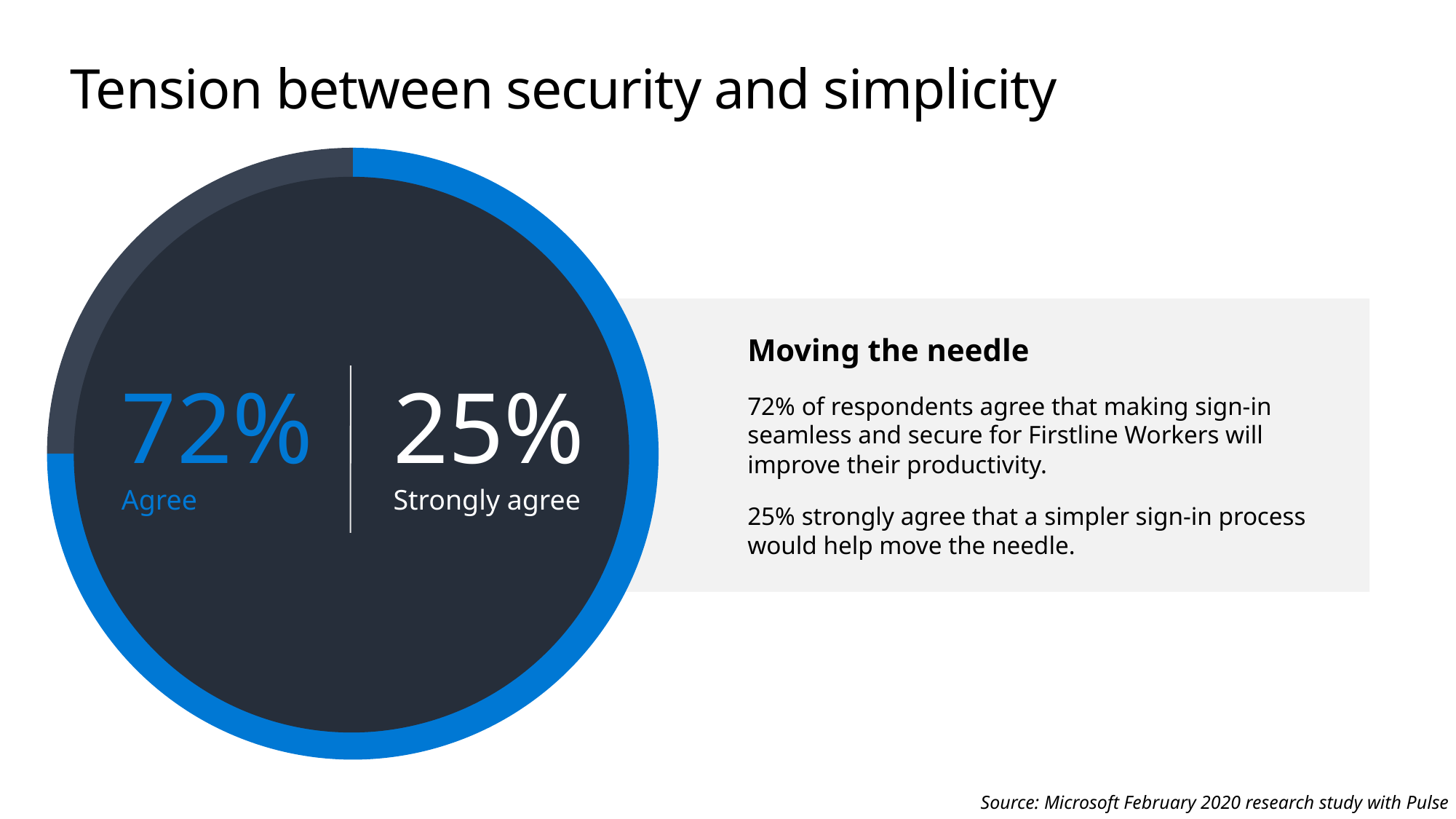
What is the title of the slide containing the chart? Tension between security and simplicity Is the Agree percentage greater or less than 50%? greater How many percentage values are labelled inside the chart? 2 What colour is used for the Agree portion of the donut ring? Blue Which of the two labelled responses has the lowest percentage? Strongly agree Is the Strongly agree percentage greater or less than 50%? less Which response has the higher percentage, Agree or Strongly agree? Agree What kind of chart is shown on the slide? Donut chart What is the difference in percentage points between Agree and Strongly agree? 47 percentage points What percentage of respondents strongly agree? 25% What percentage of respondents agree? 72%